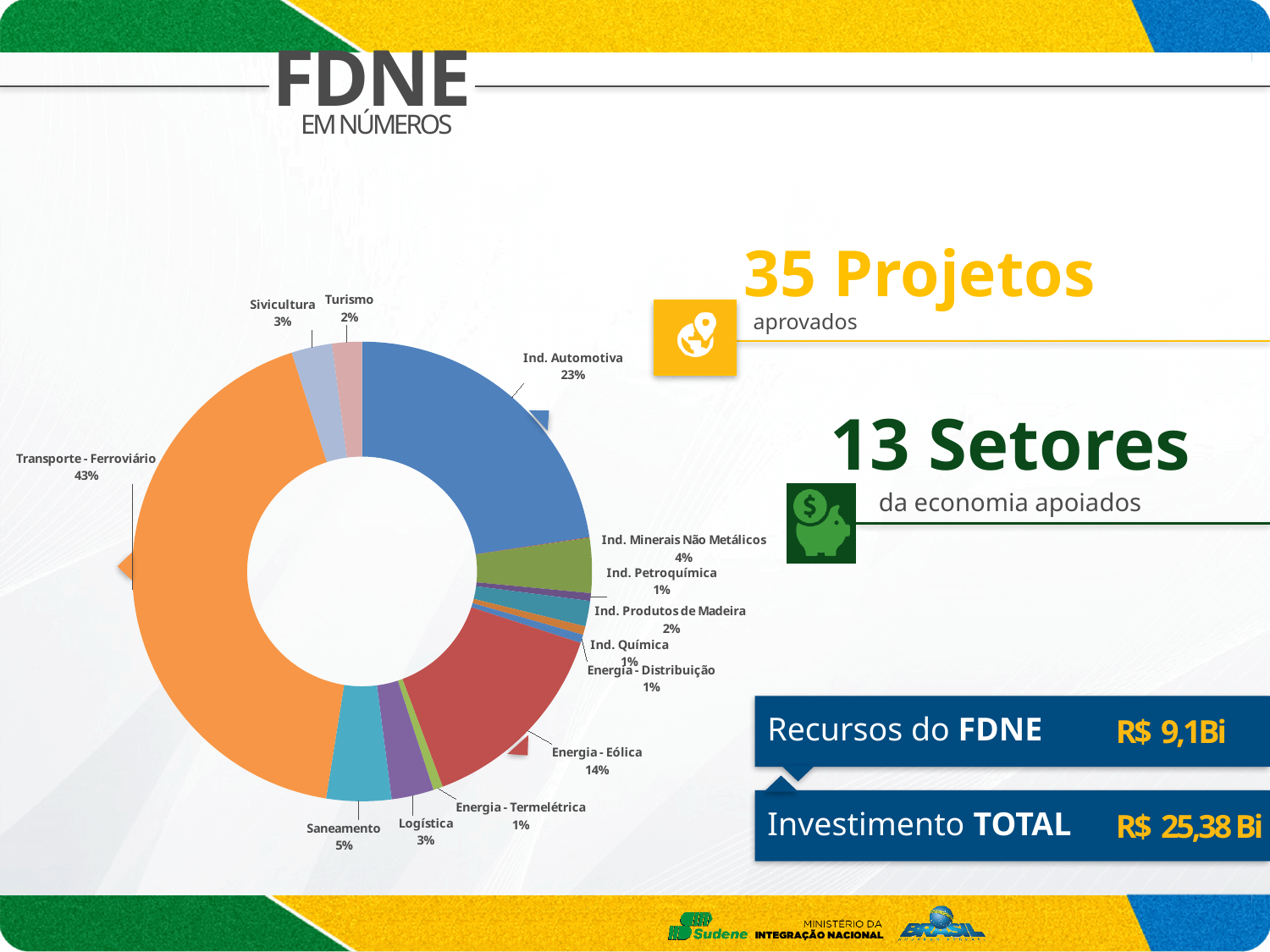
What colour is the Transporte - Ferroviário slice? orange What share of the pie chart does Transporte - Ferroviário represent? 43% Which has a larger share, Energia - Eólica or Saneamento? Energia - Eólica What kind of chart is shown on the slide? doughnut chart What is the value labelled for Energia - Eólica? 14% What percentage is shown for Ind. Automotiva in the chart? 23% How many sectors (slices) are shown in the chart? 13 What percentage is shown for Turismo? 2% What percentage does Saneamento account for in the chart? 5% Which sector has the largest share in the chart? Transporte - Ferroviário Which is larger, Ind. Minerais Não Metálicos or Logística? Ind. Minerais Não Metálicos What is the difference in percentage points between Transporte - Ferroviário and Ind. Automotiva? 20